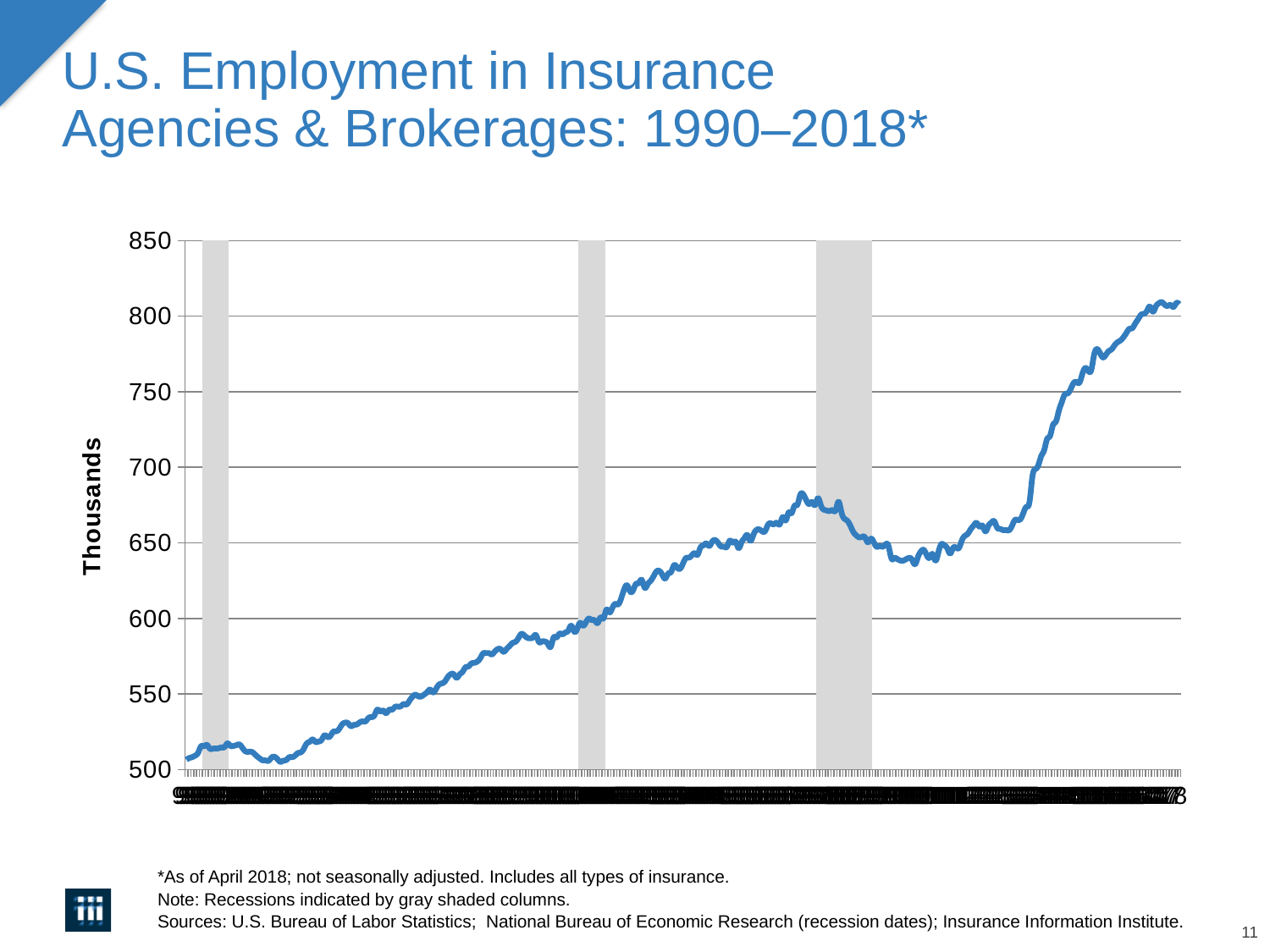
Is the lowest point of the line after the third gray shaded column greater or less than 600? greater What is the label on the vertical axis? Thousands Which is larger: the value at the right end of the line or the value at the left end of the line? the right end Overall, do the values rise or fall from the left end of the x axis to the right end? rise How many gray shaded columns (recessions) are shown on the chart? 3 Is the value at the left end of the line (the earliest point) greater or less than 550? less Is the peak of the line just before the third gray shaded column greater or less than 700? less What kind of chart is shown on the slide? line chart What is the highest value shown on the vertical axis? 850